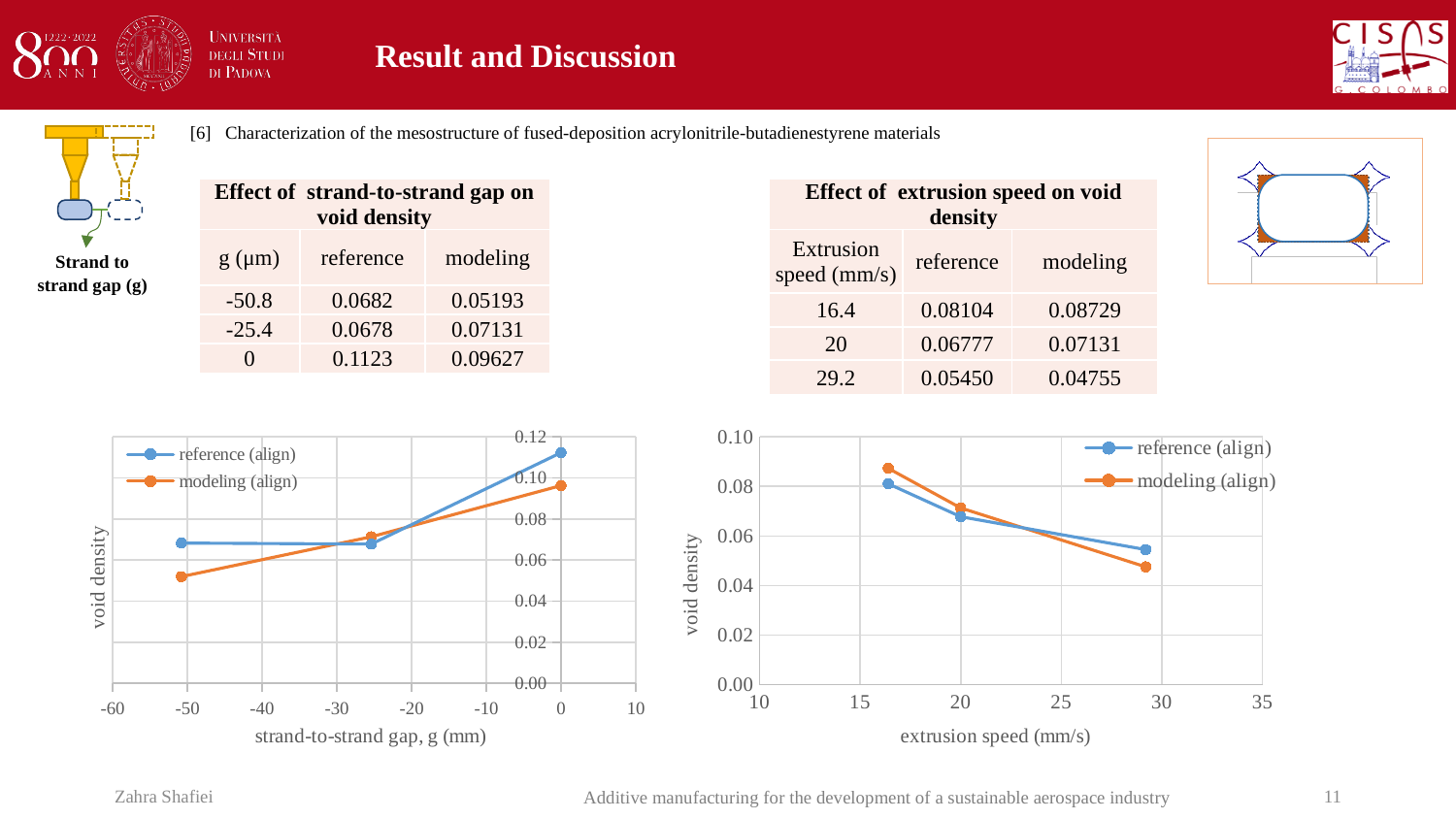
In the right chart (void density vs extrusion speed), at which extrusion speed is the reference (align) void density highest? 16.4 According to the slide, what is the reference void density at a strand-to-strand gap of 0 µm? 0.1123 In the left chart (void density vs strand-to-strand gap), does the modeling (align) void density rise or fall as the gap goes from -50 toward 0? rise In the right chart (void density vs extrusion speed), does the reference (align) void density rise or fall as extrusion speed increases? fall In the right chart (void density vs extrusion speed), is the modeling (align) void density at the highest extrusion speed greater or less than 0.06? less In the left chart (void density vs strand-to-strand gap), is the modeling (align) void density at the leftmost point (gap -50.8) greater or less than 0.06? less In the left chart (void density vs strand-to-strand gap), at a gap of 0, which series has the higher void density, reference (align) or modeling (align)? reference (align) How many series does the legend of the right chart (void density vs extrusion speed) list? 2 In the right chart (void density vs extrusion speed), how many data points does the reference (align) series have? 3 In the left chart (void density vs strand-to-strand gap), is the reference (align) void density at a gap of 0 greater or less than 0.10? greater What kind of chart is the left chart, plotting void density against strand-to-strand gap? line chart What is the x-axis title of the right chart? extrusion speed (mm/s)